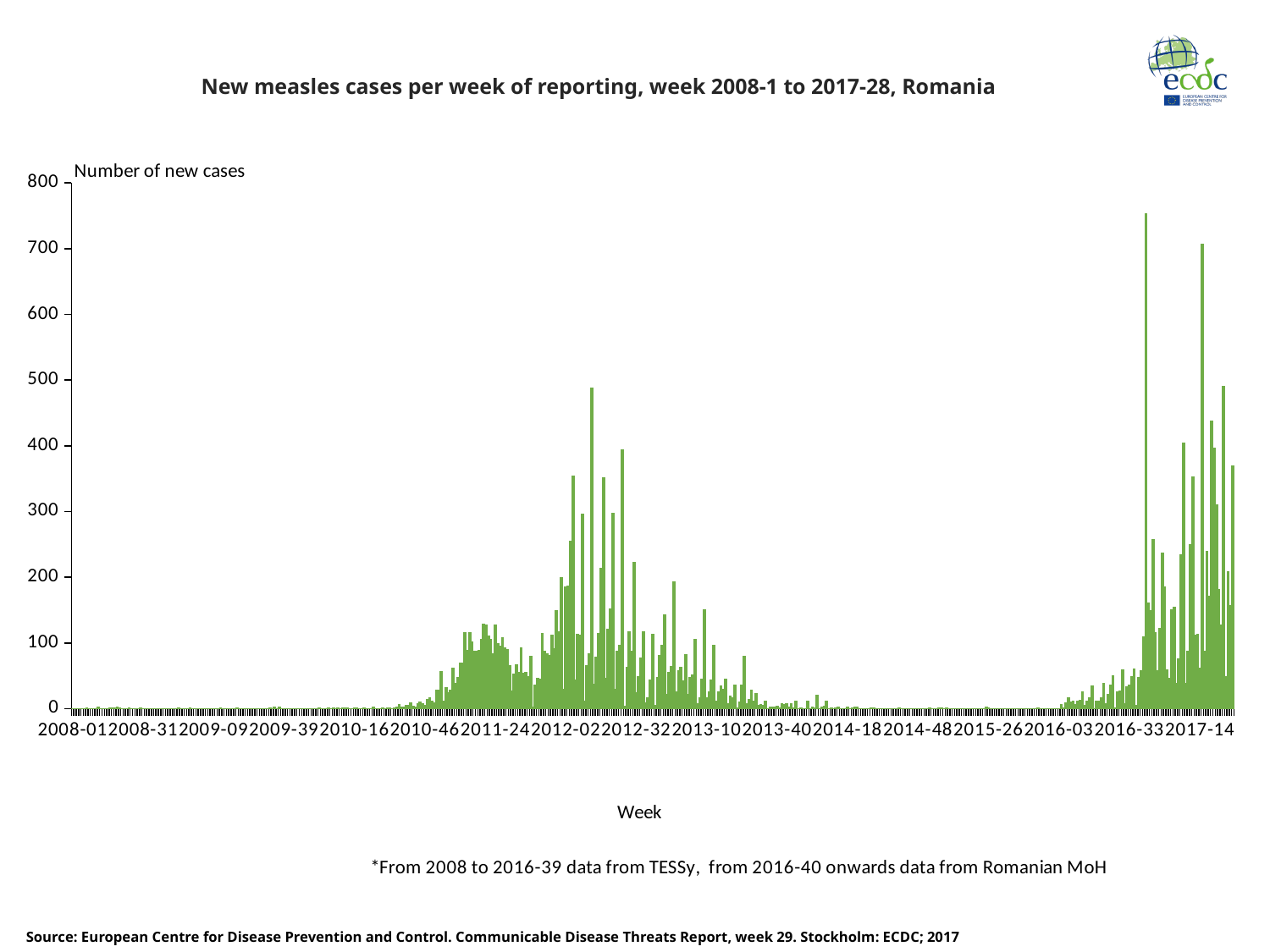
What is the highest value shown on the vertical axis? 800 Is the tallest bar in the 2012 outbreak (around 2012-02) greater or less than 400? greater How many week labels are printed along the x axis? 17 Is the tallest bar on the chart greater or less than 700? greater How many data series are plotted on the chart? 1 What is the title of the chart? New measles cases per week of reporting, week 2008-1 to 2017-28, Romania Which is higher, the tallest bar in the 2012 outbreak or the tallest bar in the 2017 outbreak? the 2017 outbreak Is the value for week 2008-01 greater or less than 100? less What kind of chart is shown on the slide? bar chart In which period does the chart reach its highest weekly value: around 2011, around 2012, or around 2017? around 2017 What is the label of the vertical axis? Number of new cases